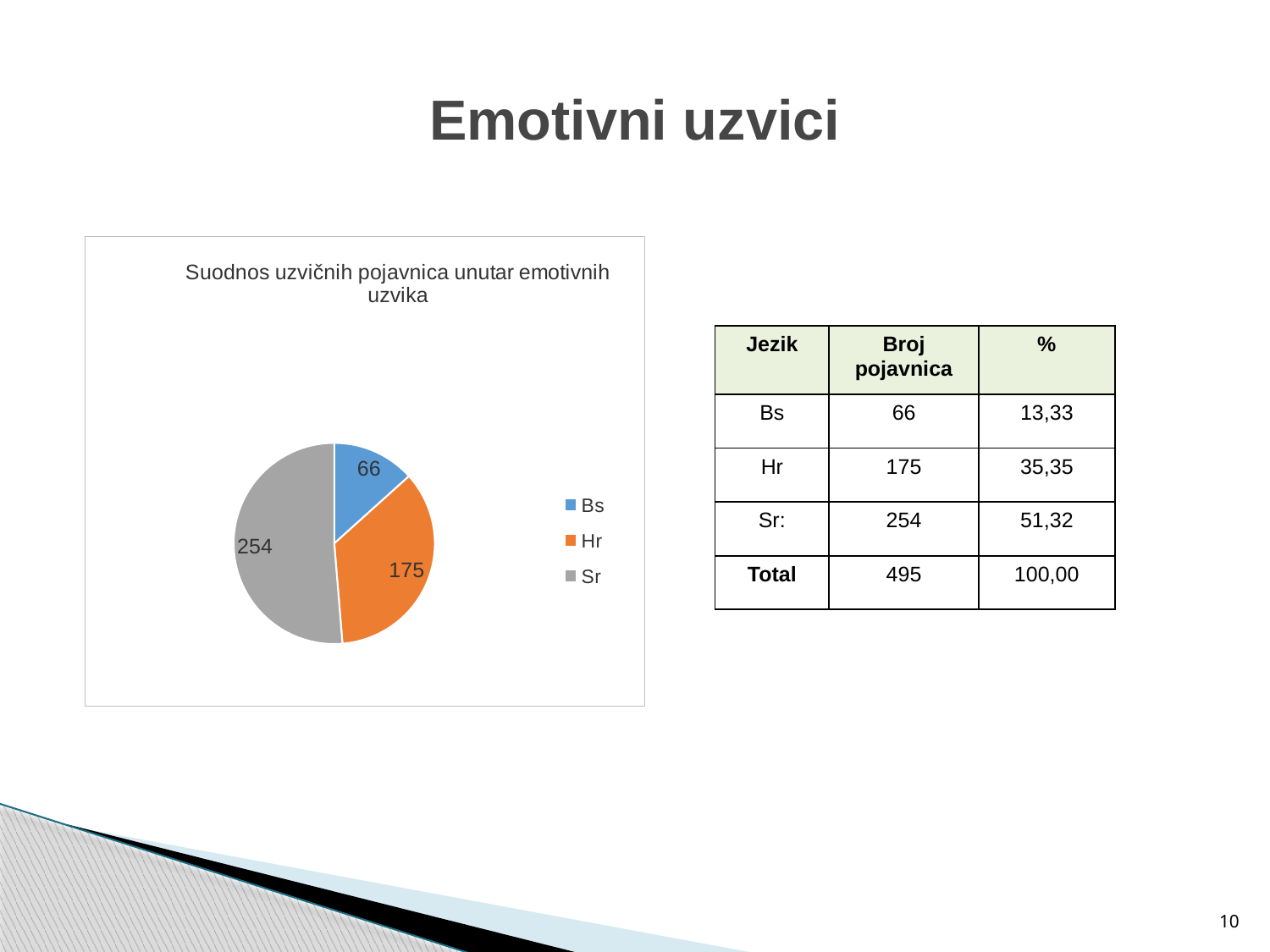
How many slices does the pie chart have? 3 What is the difference between the values for Hr and Bs in the pie chart? 109 What is the value for Bs in the pie chart? 66 What kind of chart is shown on the slide? pie chart Which colour represents Hr in the pie chart? orange What is the difference between the values for Sr and Hr in the pie chart? 79 What is the title of the pie chart? Suodnos uzvičnih pojavnica unutar emotivnih uzvika What is the value for Hr in the pie chart? 175 Which is larger in the pie chart, Hr or Bs? Hr What is the value for Sr in the pie chart? 254 Which category has the largest slice in the pie chart? Sr Which category has the smallest slice in the pie chart? Bs